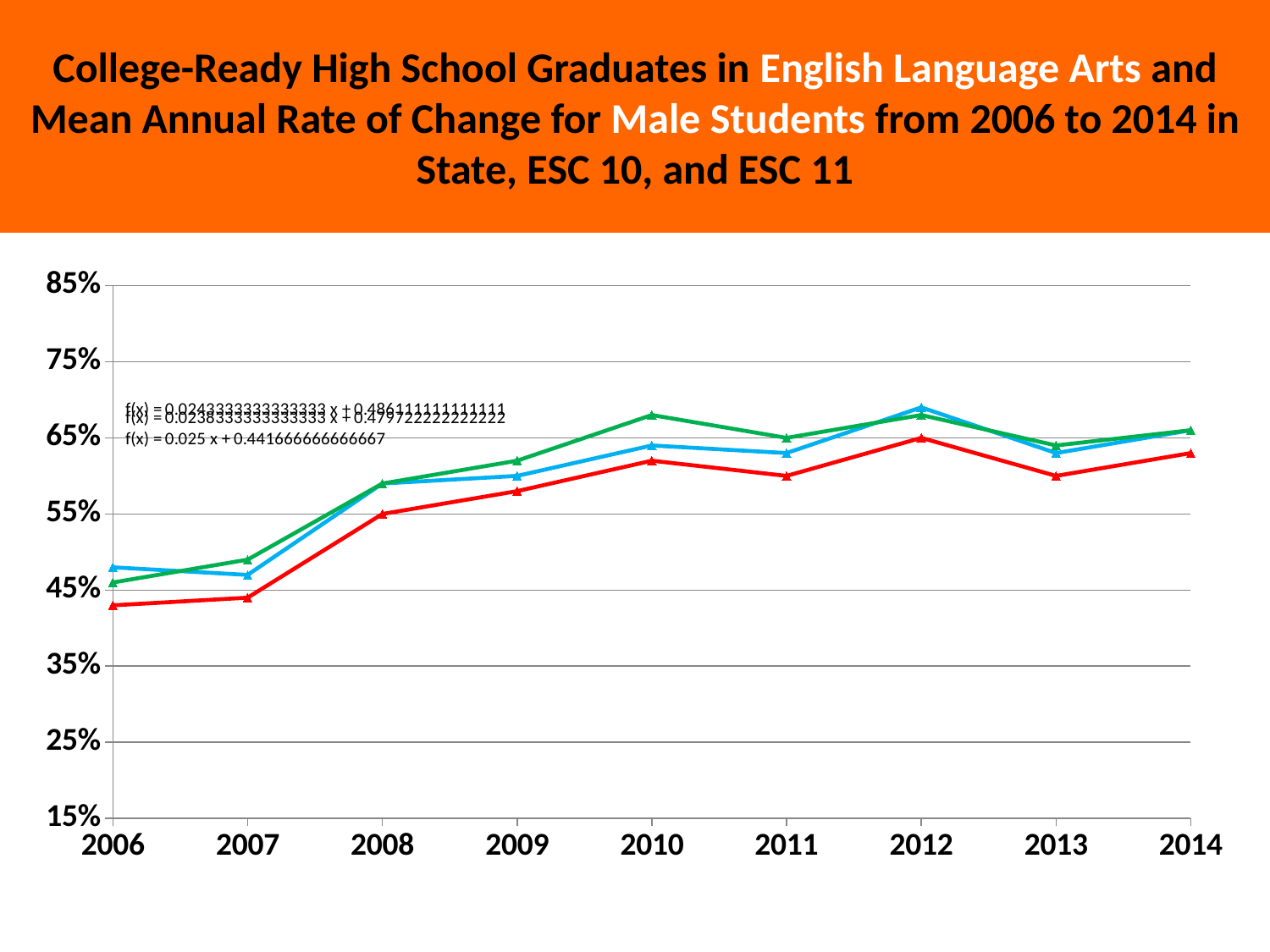
Is the value of the blue line in 2012 greater or less than 65%? greater What kind of chart is shown on the slide? line chart In 2010, which line has the higher value, the red line or the green line? green line Is the value of the red line in 2013 greater or less than 65%? less How many years are plotted along the x axis? 9 In which year does the red line reach its lowest value? 2006 How many lines are plotted on the chart? 3 Is the value of the green line in 2010 greater or less than 65%? greater Which group of students does the chart title say the data is for? Male Students Does the red line rise or fall from 2006 to 2010? rise